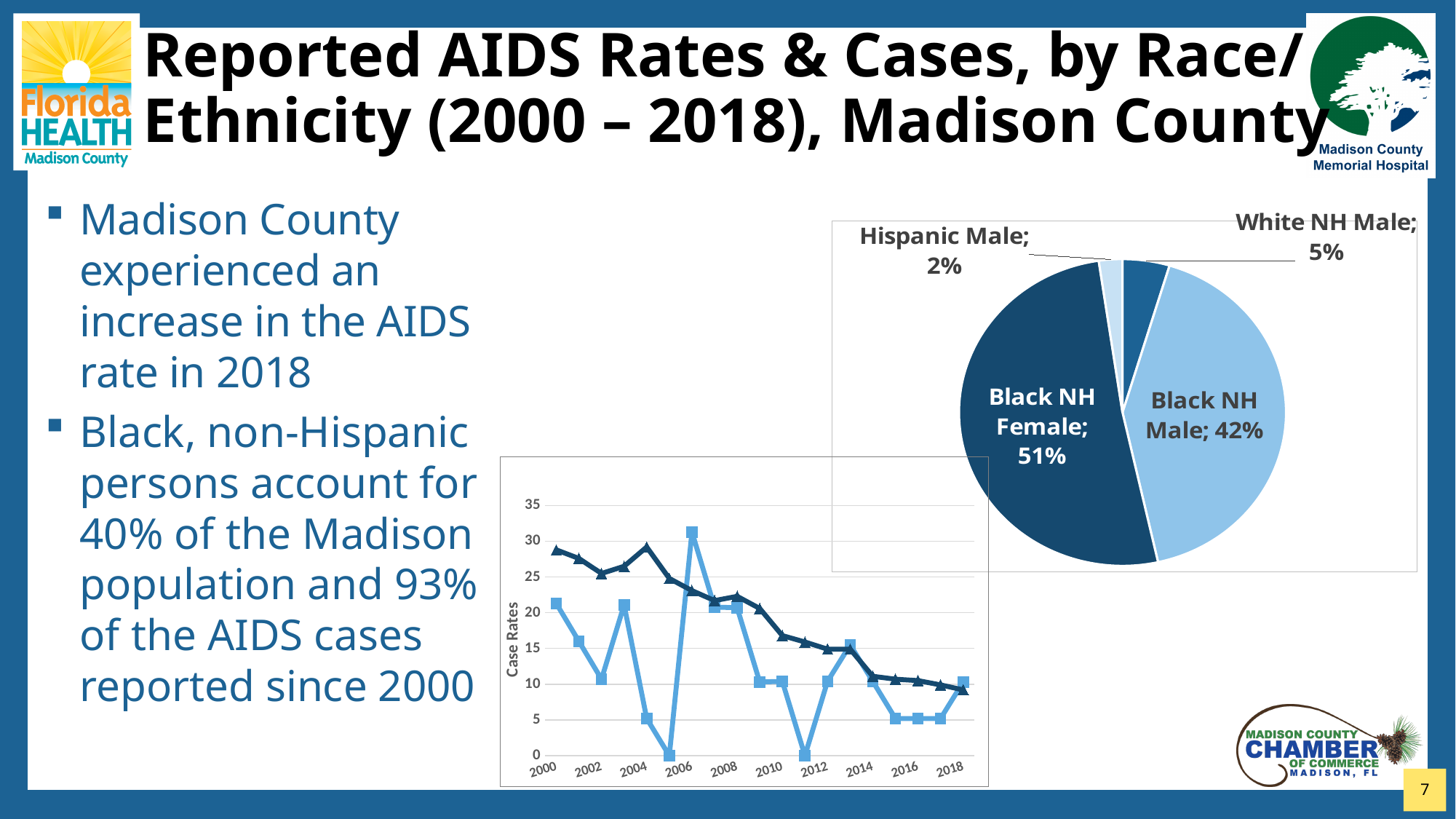
In the pie chart, what share of AIDS cases is attributed to Black NH Male? 42% In the pie chart, how many percentage points larger is the Black NH Female share than the Black NH Male share? 9 In the pie chart, which category has the smallest slice? Hispanic Male How many slices does the pie chart have? 4 In the pie chart, what percentage is shown for White NH Male? 5% In the pie chart, what share of AIDS cases is attributed to Black NH Female? 51% What kind of chart is the chart at the bottom of the slide showing Case Rates? Line chart In the bottom line chart, is the value of the dark navy line with triangle markers in 2000 greater or less than 25? greater In the bottom line chart, does the dark navy line with triangle markers generally rise or fall from 2000 to 2018? Fall In the pie chart, what percentage is shown for Hispanic Male? 2% In the pie chart, which category has the largest slice? Black NH Female In the pie chart, which is larger: the White NH Male slice or the Hispanic Male slice? White NH Male